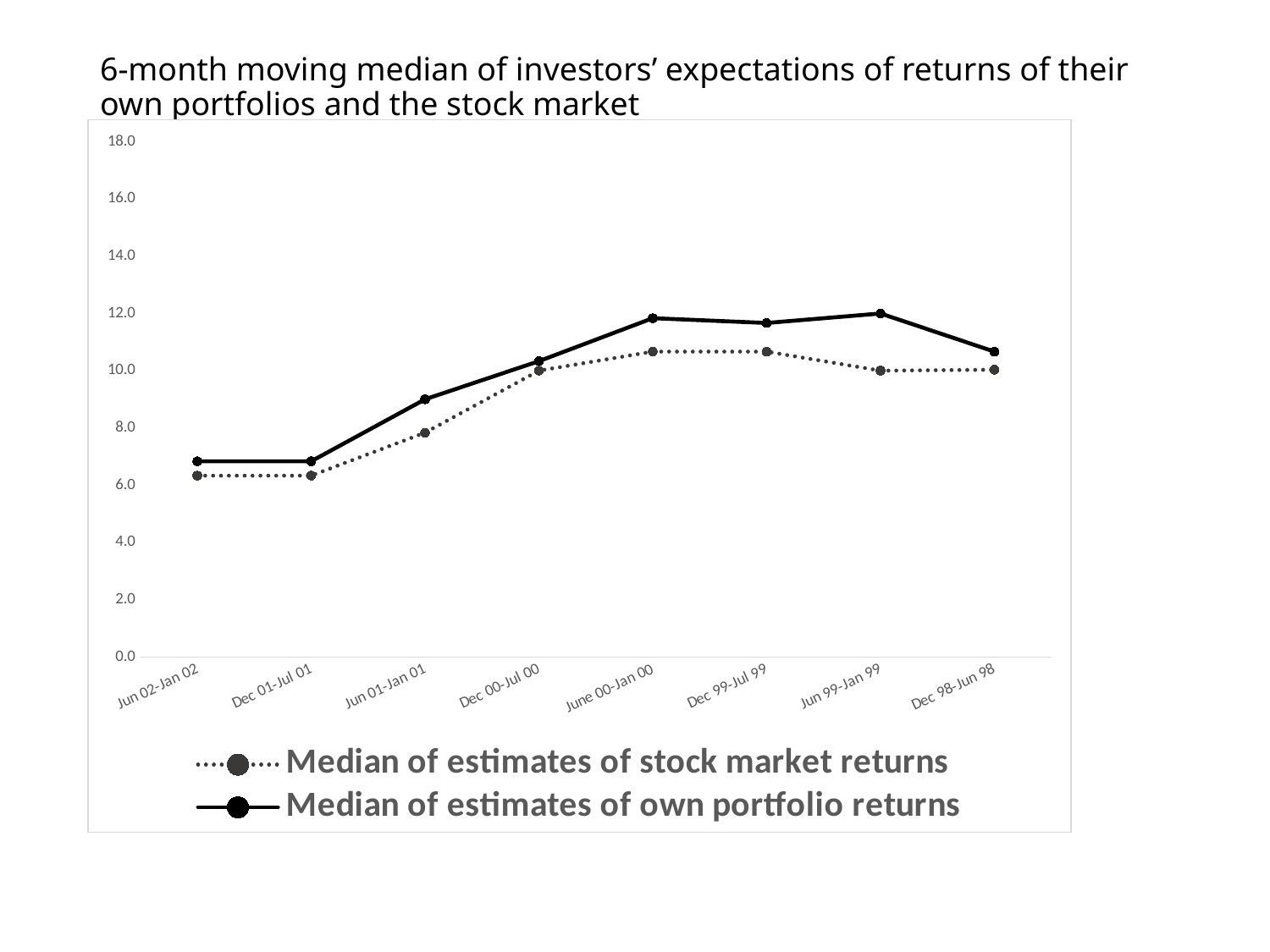
Does the Median of estimates of own portfolio returns rise or fall from Dec 01-Jul 01 to June 00-Jan 00? rise How many series does the legend list? 2 What kind of chart is shown on the slide? line chart For Dec 98-Jun 98, which series has the larger value: Median of estimates of stock market returns or Median of estimates of own portfolio returns? Median of estimates of own portfolio returns Is the value of Median of estimates of own portfolio returns for Jun 99-Jan 99 greater or less than 10.0? greater How many periods are plotted along the x axis? 8 Is the value of Median of estimates of stock market returns for Dec 98-Jun 98 greater or less than 12.0? less Which series is drawn with a dotted line? Median of estimates of stock market returns Is the value of Median of estimates of stock market returns for Jun 02-Jan 02 greater or less than 8.0? less Does the Median of estimates of stock market returns rise or fall from Dec 99-Jul 99 to Jun 99-Jan 99? fall For Jun 01-Jan 01, which series has the larger value: Median of estimates of stock market returns or Median of estimates of own portfolio returns? Median of estimates of own portfolio returns